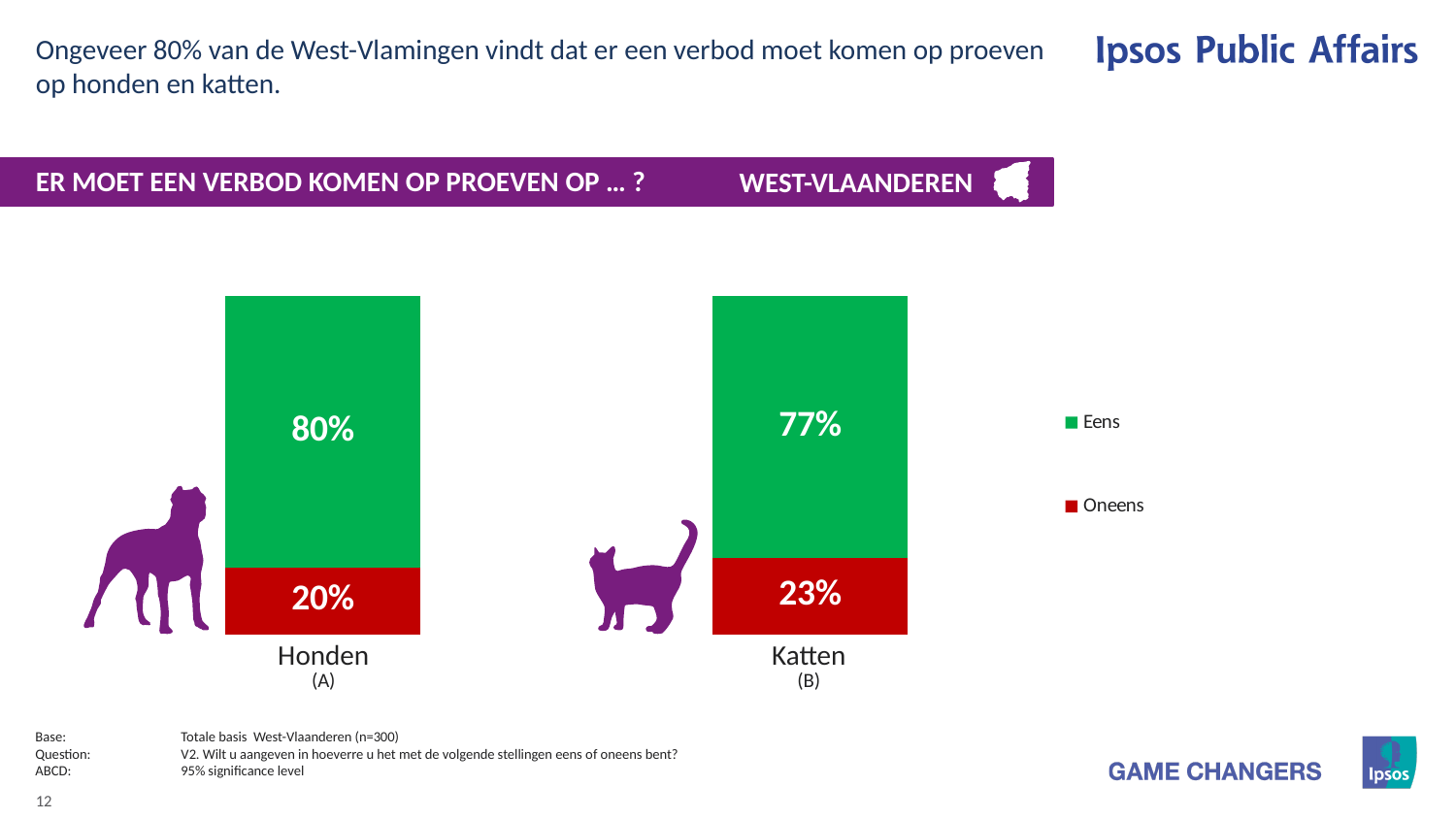
What is the difference between the 'Oneens' share for Katten and the 'Oneens' share for Honden? 3% Which colour represents 'Oneens' in the chart? Red What percentage of respondents answered 'Eens' for Honden? 80% What percentage of respondents answered 'Oneens' for Honden? 20% How many series does the legend list? 2 What percentage of respondents answered 'Oneens' for Katten? 23% Which category has the higher 'Eens' share, Honden or Katten? Honden How many categories are shown on the x axis of the chart? 2 What kind of chart is shown on the slide? Stacked bar chart What is the difference between the 'Eens' share for Honden and the 'Eens' share for Katten? 3% Which category has the lowest 'Oneens' share? Honden What percentage of respondents answered 'Eens' for Katten? 77%